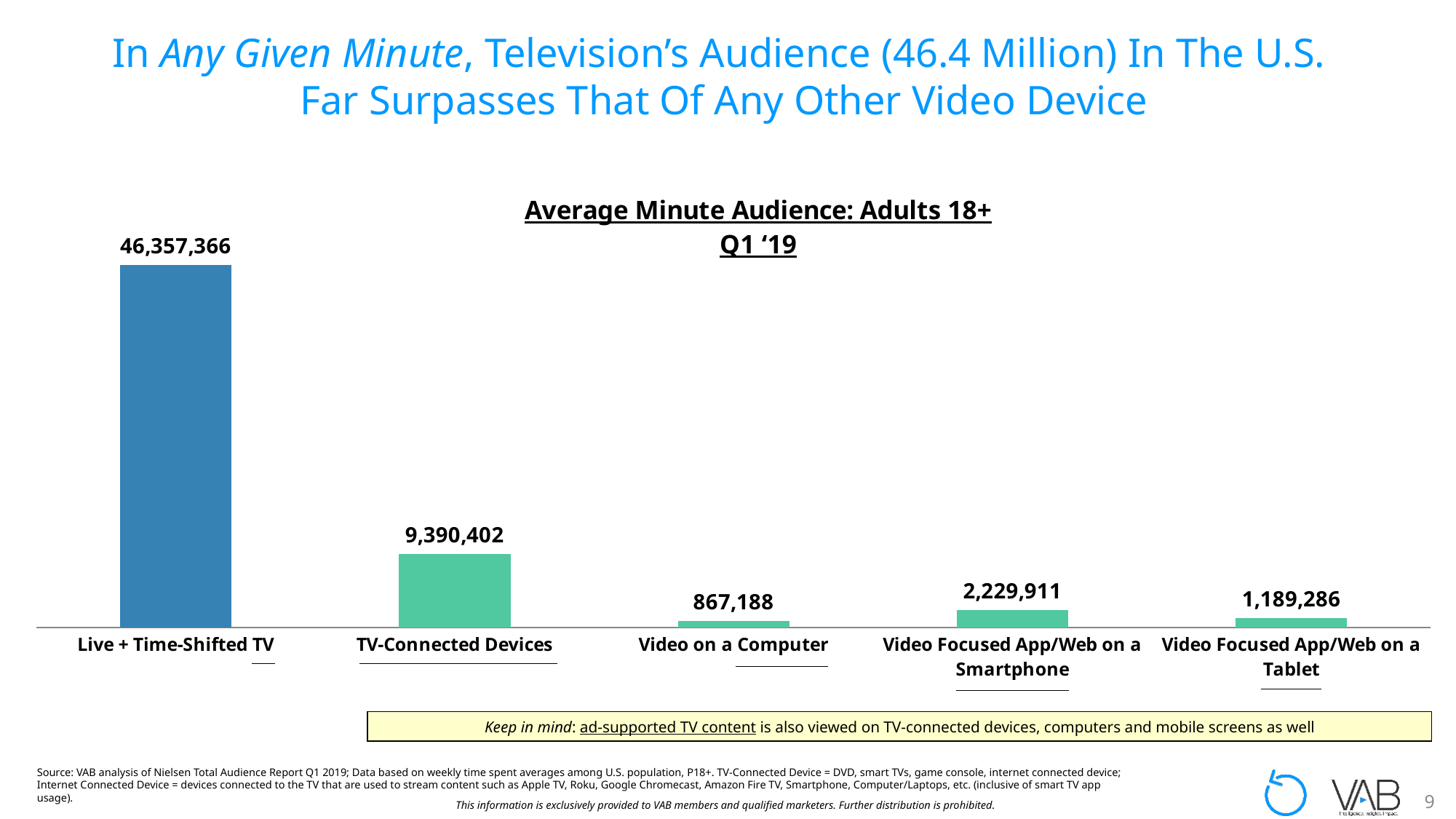
What is the value shown for Video Focused App/Web on a Tablet? 1,189,286 Which category has the highest average minute audience? Live + Time-Shifted TV What is the value shown for Video Focused App/Web on a Smartphone? 2,229,911 Which category has the lowest average minute audience? Video on a Computer How many categories are shown in the chart? 5 What is the difference between the Live + Time-Shifted TV value and the TV-Connected Devices value? 36,966,964 What is the average minute audience for Live + Time-Shifted TV? 46,357,366 What is the value shown for Video on a Computer? 867,188 Which is larger, the value for Video Focused App/Web on a Smartphone or the value for Video Focused App/Web on a Tablet? Video Focused App/Web on a Smartphone What is the difference between the Smartphone value and the Tablet value? 1,040,625 What is the value shown for TV-Connected Devices? 9,390,402 What type of chart is shown on the slide? Bar chart